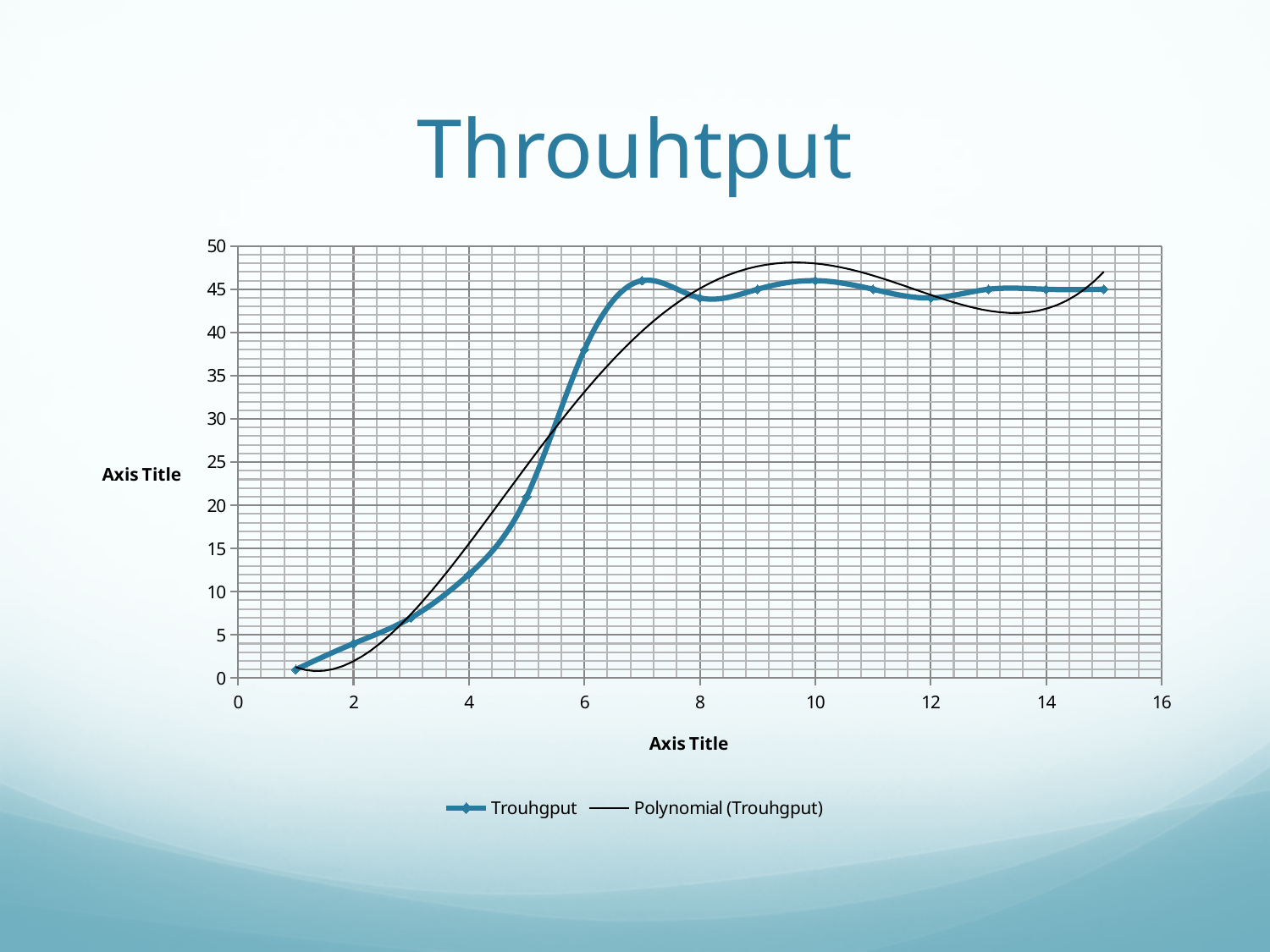
Is the Trouhgput value at x=4 greater or less than 15? less At which x value is the Trouhgput series lowest? 1 What kind of chart is shown on the slide? Line chart Do the Trouhgput values rise or fall along the x axis from x=1 to x=7? Rise Is the Trouhgput value at x=10 greater or less than 40? greater Which has the larger Trouhgput value, x=3 or x=6? x=6 What are the two legend entries of the chart? Trouhgput and Polynomial (Trouhgput) Is the Trouhgput value at x=6 greater or less than 30? greater How many entries does the legend list? 2 What is the title of the chart? Throuhtput How many data points are plotted for the Trouhgput series? 15